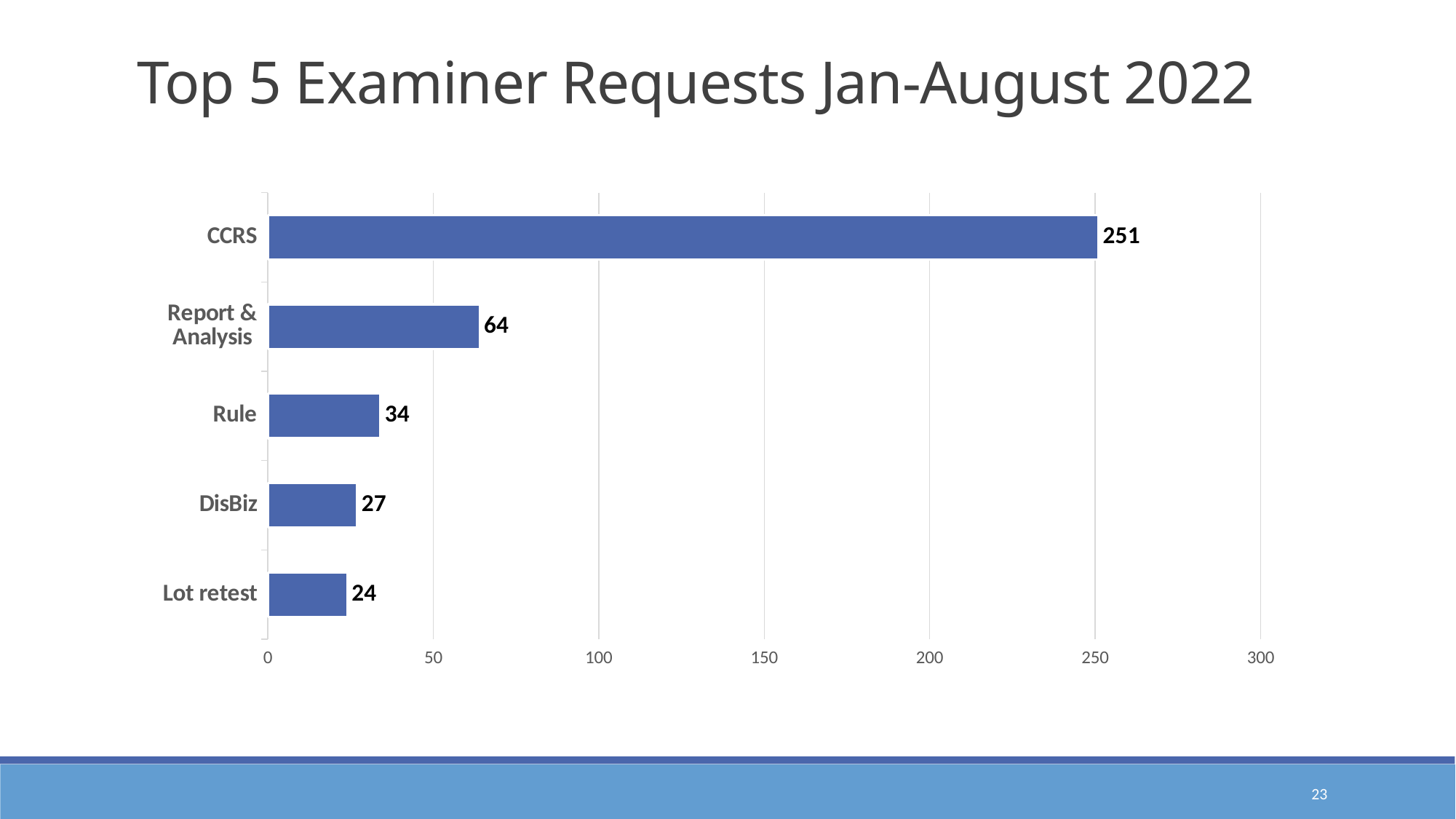
What is the difference between the values for Rule and DisBiz? 7 How many categories are shown in the chart? 5 What is the title of the slide? Top 5 Examiner Requests Jan-August 2022 What is the value for CCRS? 251 Which is larger, the value for Rule or the value for DisBiz? Rule What is the difference between the values for CCRS and Report & Analysis? 187 Is the value for CCRS greater or less than 200? greater What is the value for Lot retest? 24 What kind of chart is shown on the slide? bar chart Which category has the highest value? CCRS What is the value for Report & Analysis? 64 Which category has the lowest value? Lot retest